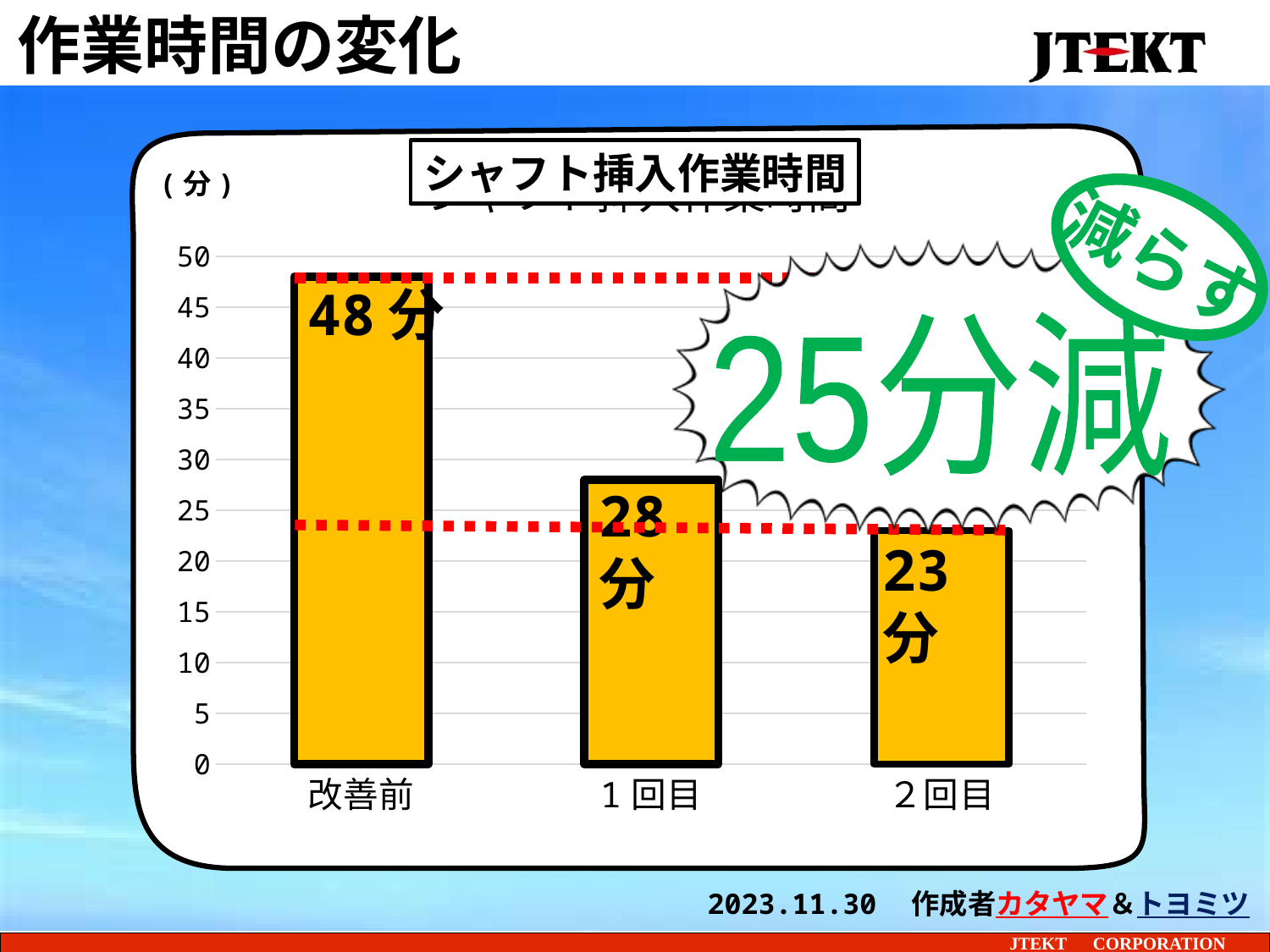
What type of chart is shown on the slide? bar chart What is the title of the chart? シャフト挿入作業時間 How many categories are plotted on the x axis? 3 What is the value for 改善前? 48分 Which category has the lowest value? 2回目 What is the value for 1回目? 28分 What is the value for 2回目? 23分 Which is larger, the value for 1回目 or the value for 2回目? 1回目 Which category has the highest value? 改善前 What is the difference between the values for 改善前 and 2回目? 25分 What is the difference between the values for 1回目 and 2回目? 5分 Do the values rise or fall from 改善前 to 2回目 along the x axis? fall